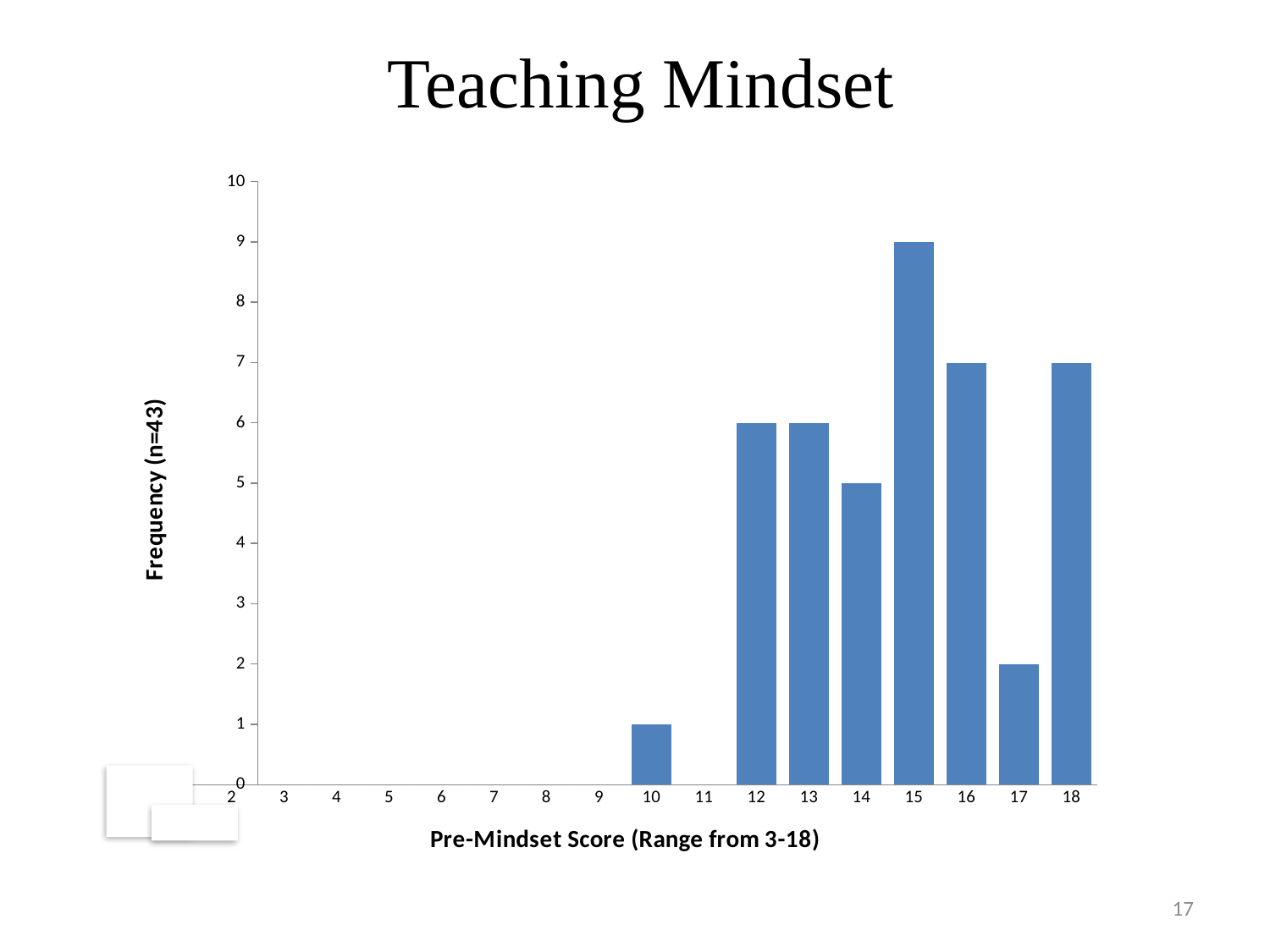
Is the frequency for a score of 15 greater or less than 8? greater What kind of chart is shown on the slide? bar chart What is the frequency for a Pre-Mindset Score of 15? 9 What is the frequency for a Pre-Mindset Score of 10? 1 What is the frequency for a Pre-Mindset Score of 17? 2 What is the frequency for a Pre-Mindset Score of 14? 5 How many bars are plotted in the chart? 8 Which has a higher frequency, a score of 16 or a score of 14? 16 Which Pre-Mindset Score with a bar has the lowest frequency? 10 What is the difference in frequency between a score of 15 and a score of 16? 2 Which Pre-Mindset Score has the highest frequency? 15 What is the label of the vertical axis? Frequency (n=43)